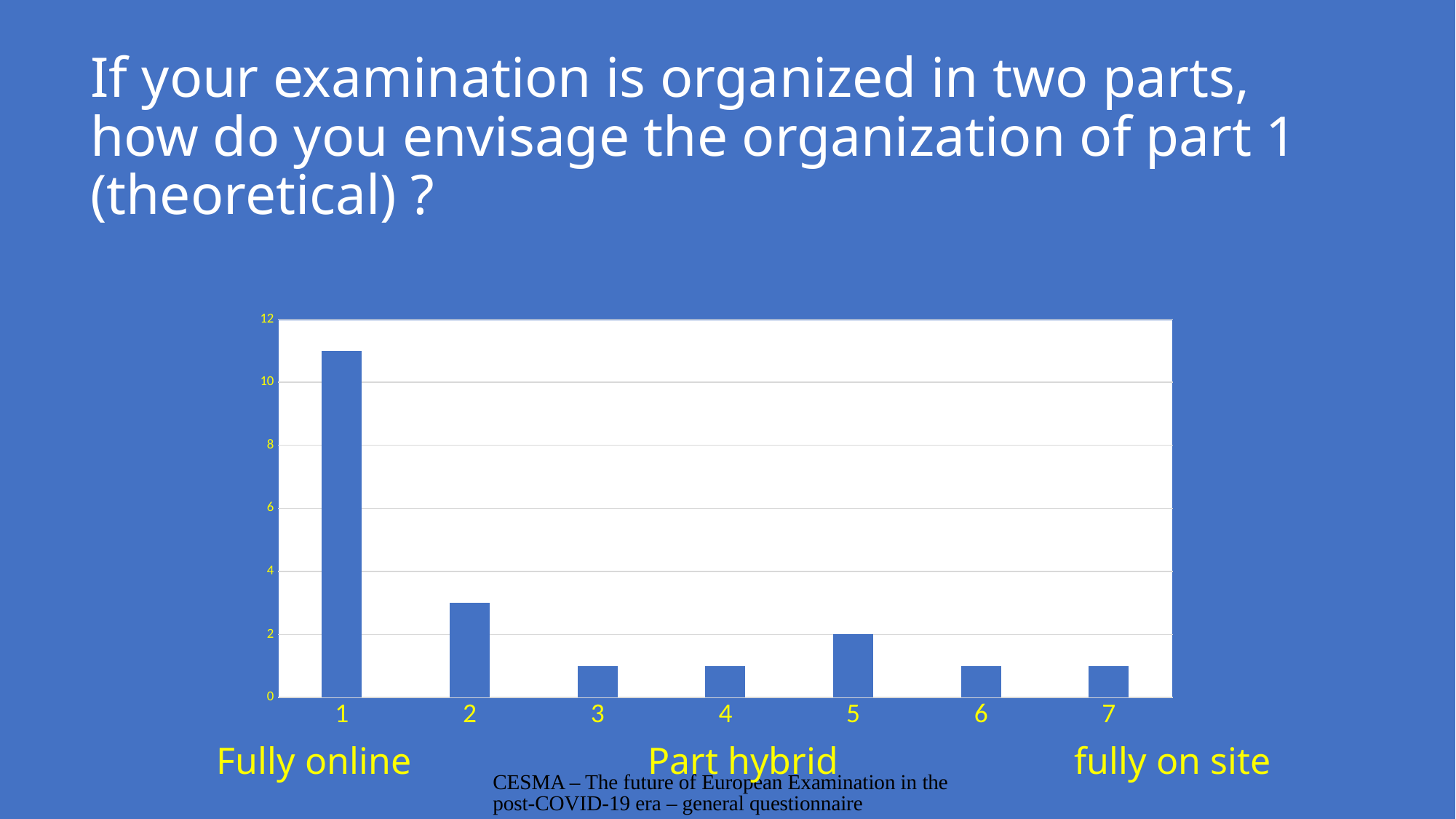
What is the value for category 5 in the chart? 2 What label is shown under the right end of the x axis, beneath category 7? fully on site What label is shown under the left end of the x axis, beneath category 1? Fully online Which category has the highest bar in the chart? 1 Is the value for category 2 greater or less than 2? greater Which is larger, the value for category 1 or the value for category 2? category 1 Is the value for category 3 greater or less than 2? less Is the value for category 1 greater or less than 10? greater How many categories are shown on the x axis of the chart? 7 Which is larger, the value for category 2 or the value for category 5? category 2 What kind of chart is shown on the slide? bar chart